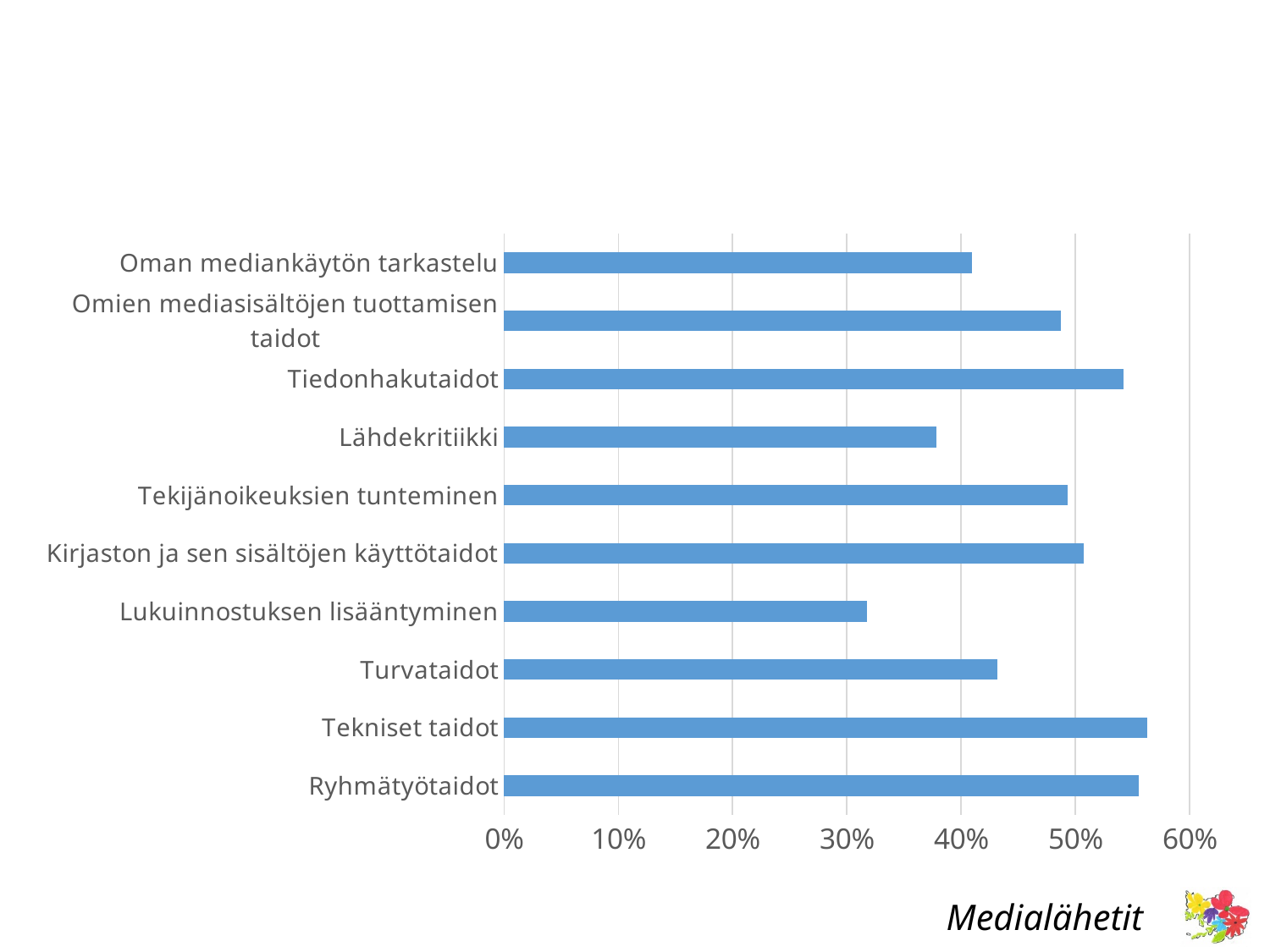
Is the value for Tiedonhakutaidot greater or less than 50%? greater Is the value for Turvataidot greater or less than 50%? less What kind of chart is shown on the slide? bar chart How many categories are plotted in the chart? 10 What is the highest value shown on the horizontal axis of the chart? 60% Which category has the lowest value in the chart? Lukuinnostuksen lisääntyminen Is the value for Lähdekritiikki greater or less than 40%? less Which has a larger value, Tiedonhakutaidot or Lähdekritiikki? Tiedonhakutaidot Which has a larger value, Turvataidot or Lukuinnostuksen lisääntyminen? Turvataidot Which has a larger value, Tekniset taidot or Oman mediankäytön tarkastelu? Tekniset taidot